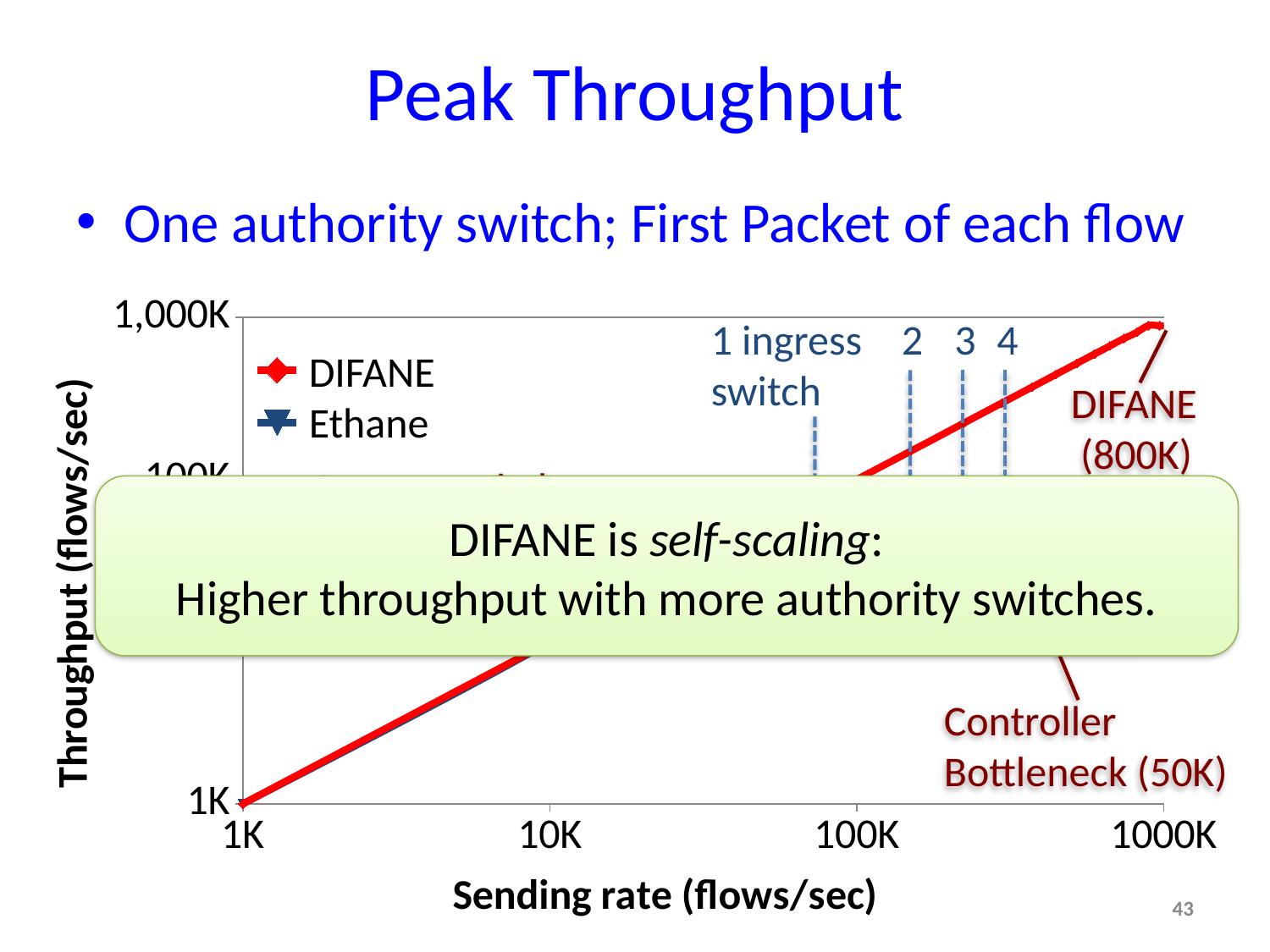
Is the DIFANE throughput at a sending rate of 1000K greater or less than 100K? greater What kind of chart is shown on the slide? line chart Does the DIFANE throughput rise or fall as the sending rate increases along the x axis? rise How many series does the chart legend list? 2 How many ingress switch markers (dashed vertical lines) are labelled on the chart? 4 Which two series are listed in the chart legend? DIFANE and Ethane Which is larger: the annotated DIFANE peak throughput or the Controller Bottleneck value? DIFANE peak throughput What is the difference between the annotated DIFANE peak throughput and the Controller Bottleneck value? 750K What is the label of the chart's x axis? Sending rate (flows/sec) What throughput value is annotated as the Controller Bottleneck? 50K What is the peak throughput annotated for DIFANE on the chart? 800K What is the throughput of the DIFANE line at a sending rate of 1K flows/sec? 1K